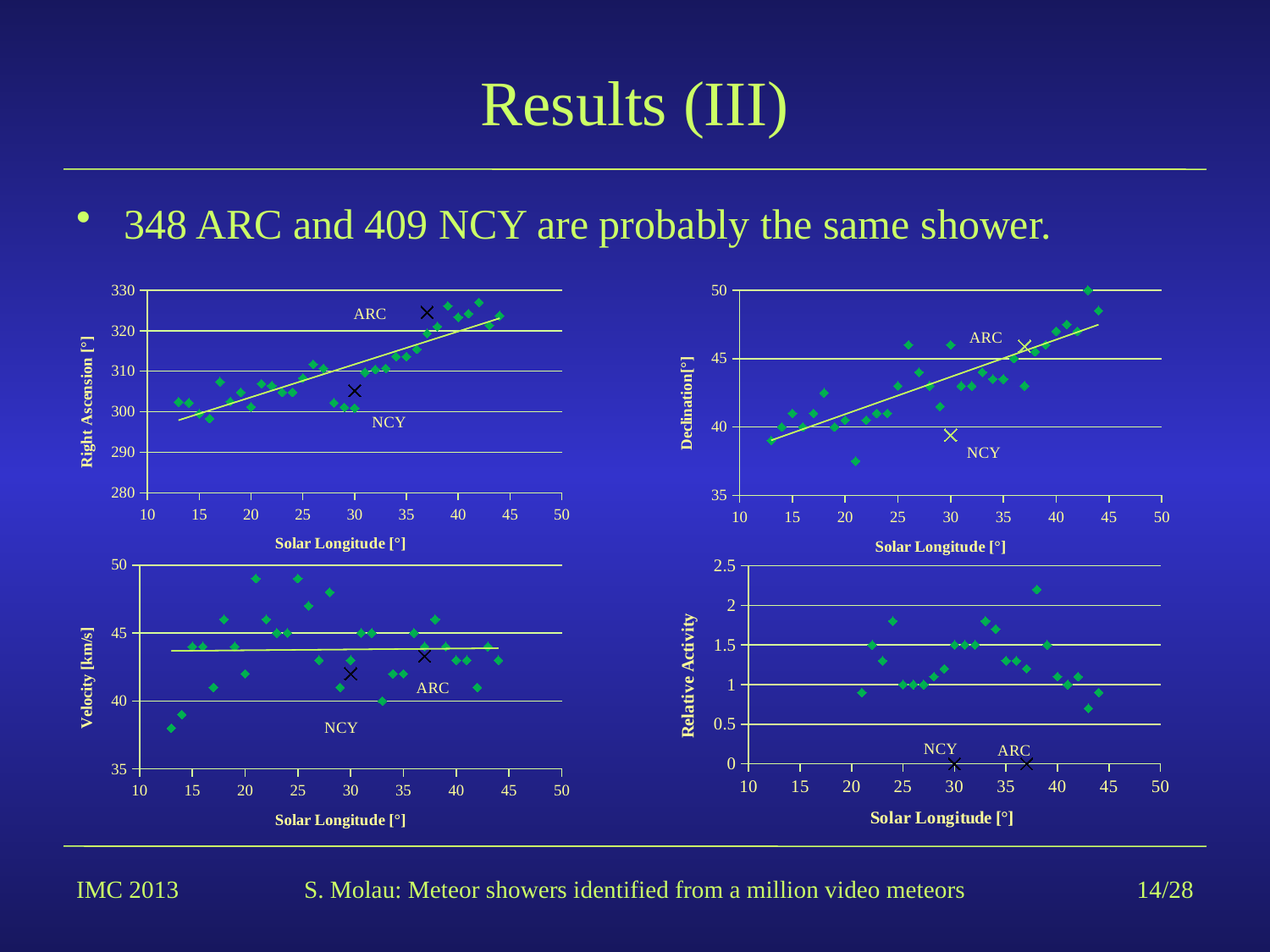
How many charts are shown on the slide? 4 In the Right Ascension chart, do the plotted values generally rise or fall as solar longitude increases? rise What is the y-axis label of the chart at the bottom left of the slide? Velocity [km/s] In the Right Ascension chart, is the value marked for ARC greater or less than 320? greater What is the x-axis label shared by all four charts on the slide? Solar Longitude [°] In the Velocity chart, is the value marked for ARC greater or less than 45? less In the Declination chart, is the value marked for NCY greater or less than 40? less What kind of chart is the Right Ascension chart at the top left of the slide? scatter chart In the Declination chart, do the plotted values generally rise or fall as solar longitude increases? rise